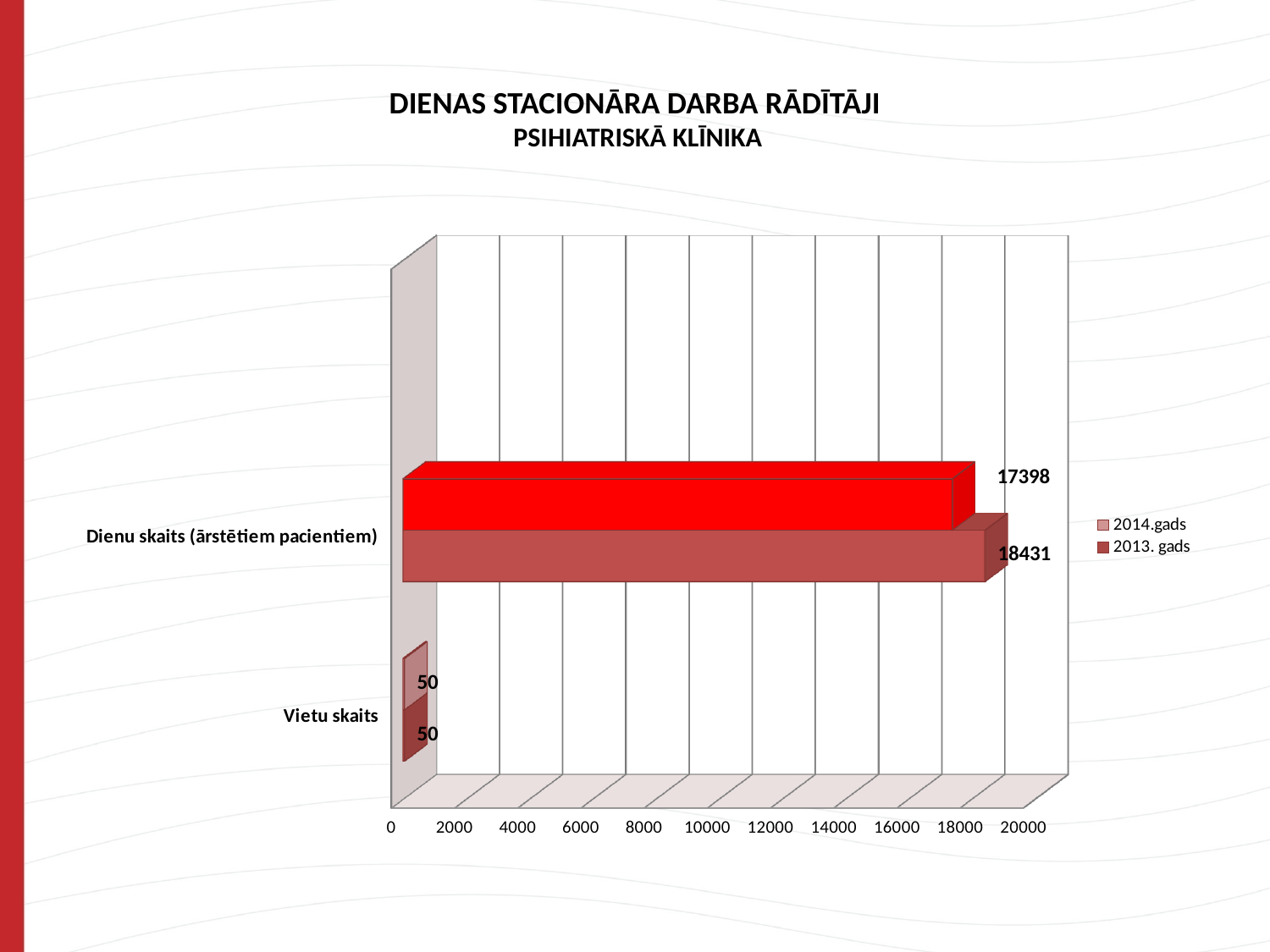
What is the value for 'Vietu skaits' in 2014.gads? 50 How many series does the legend list? 2 How many categories are shown on the chart? 2 Which year has the larger value for 'Dienu skaits (ārstētiem pacientiem)', 2013. gads or 2014.gads? 2013. gads What is the value for 'Dienu skaits (ārstētiem pacientiem)' in 2013. gads? 18431 Is the 2014.gads value for 'Dienu skaits (ārstētiem pacientiem)' greater or less than 18000? less What is the title of the chart? DIENAS STACIONĀRA DARBA RĀDĪTĀJI PSIHIATRISKĀ KLĪNIKA What is the maximum value shown on the horizontal axis? 20000 What is the difference between the 2013. gads and 2014.gads values for 'Dienu skaits (ārstētiem pacientiem)'? 1033 What is the value for 'Vietu skaits' in 2013. gads? 50 What type of chart is shown on the slide? bar chart What is the value for 'Dienu skaits (ārstētiem pacientiem)' in 2014.gads? 17398